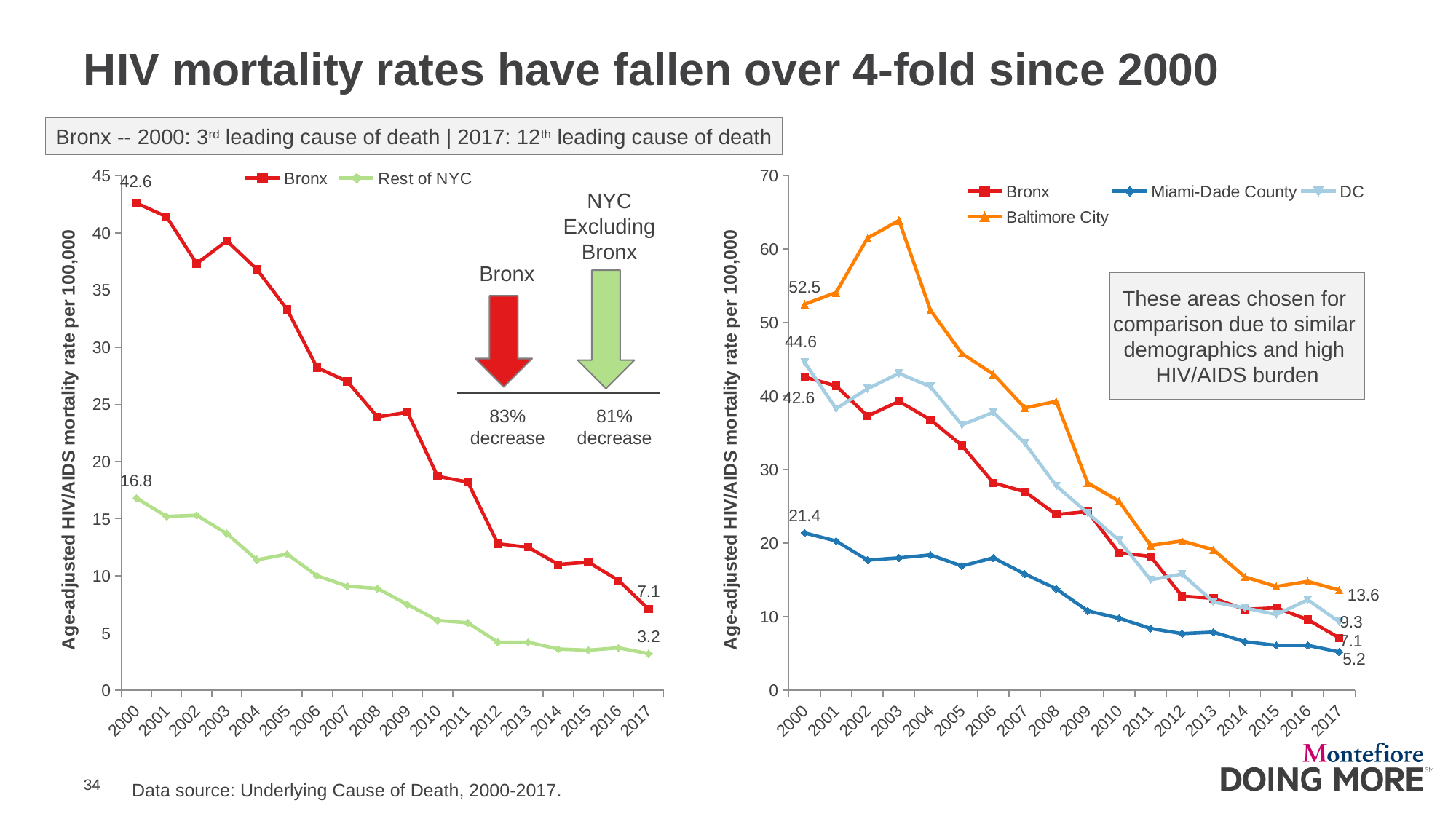
In the right chart, which area had the highest mortality rate in 2000? Baltimore City In the left chart, how many series does the legend list? 2 In the left chart, does the Bronx mortality rate rise or fall from 2000 to 2017? fall In the right chart, how many series does the legend list? 4 What type of chart is the right chart? line chart In the right chart, what was the DC mortality rate in 2000? 44.6 In the left chart, what was the Bronx HIV/AIDS mortality rate per 100,000 in 2000? 42.6 In the right chart, what was the Miami-Dade County mortality rate in 2017? 5.2 In the left chart, what is the difference between the Bronx and Rest of NYC rates in 2000? 25.8 In the left chart, what was the Rest of NYC mortality rate in 2017? 3.2 In the left chart, is the Bronx value for 2006 greater or less than 25? greater In the right chart, which is larger in 2017: the Baltimore City rate or the DC rate? Baltimore City